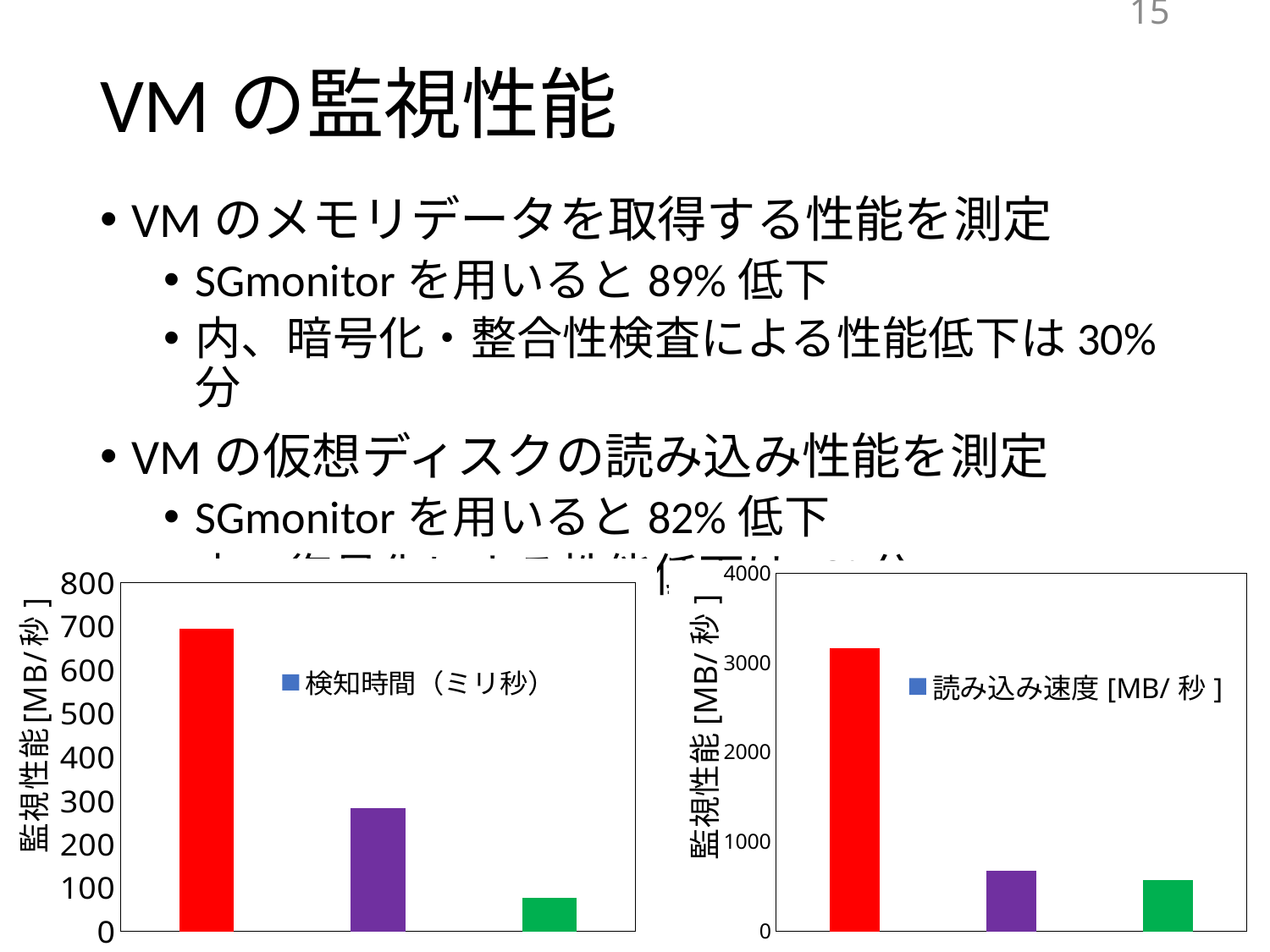
What kind of chart is the left chart on the slide? bar chart In the right chart, is the value of the red bar greater or less than 3000? greater How many series does the legend of the right chart list? 1 In the right chart, which coloured bar is the tallest? red In the left chart, which coloured bar is the tallest? red In the left chart, is the value of the red bar greater or less than 600? greater In the left chart, is the value of the purple bar greater or less than 300? less In the left chart, which coloured bar is the shortest? green How many bars are plotted in the left chart? 3 How many bars are plotted in the right chart? 3 Do the bar values in the left chart rise or fall from left to right? fall